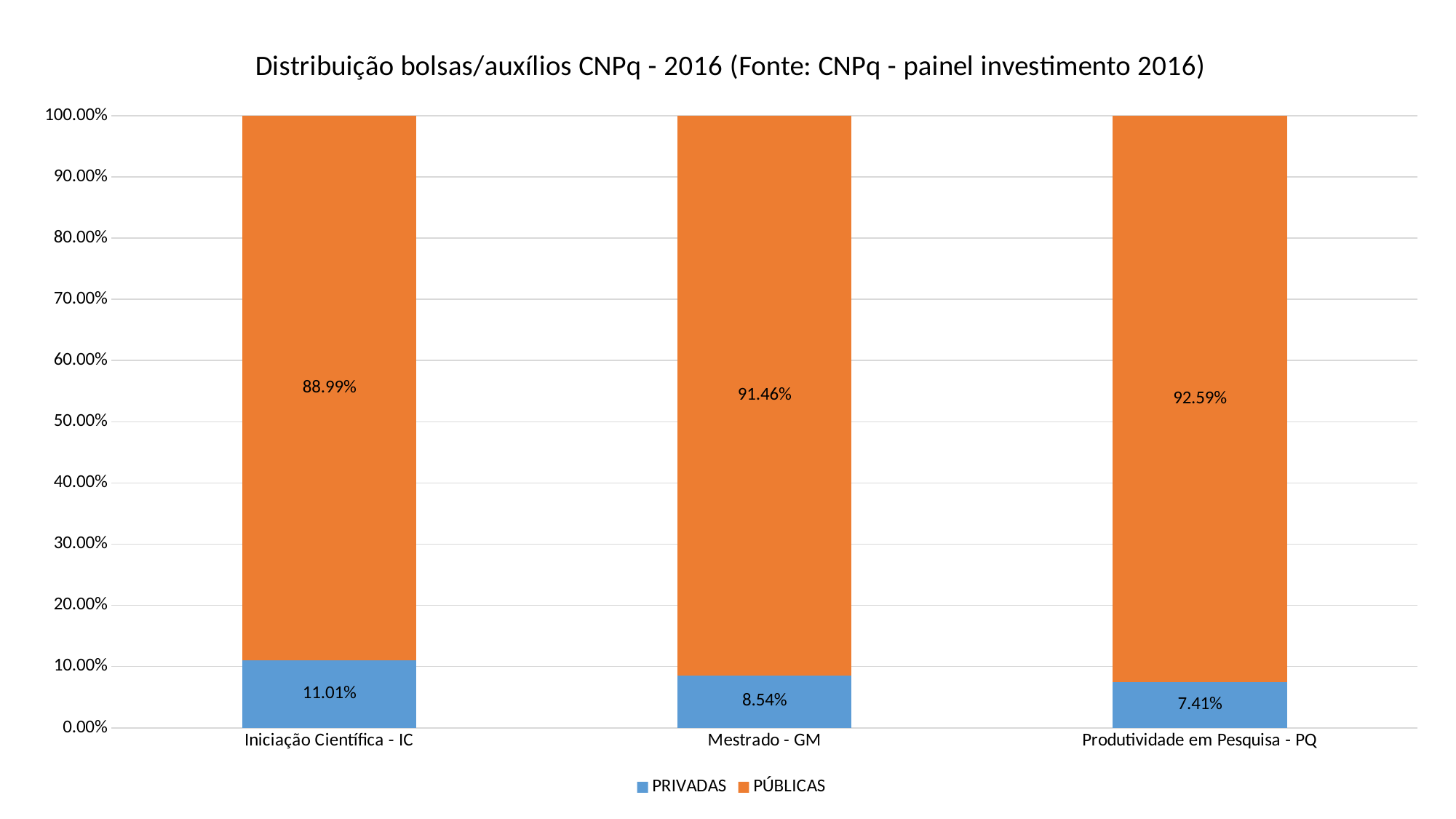
What is the PRIVADAS value for Iniciação Científica - IC? 11.01% Which category has the lowest PÚBLICAS value? Iniciação Científica - IC What kind of chart is shown on the slide? Stacked bar chart What is the difference between the PÚBLICAS values for Produtividade em Pesquisa - PQ and Iniciação Científica - IC? 3.60% Which is larger: the PRIVADAS value for Mestrado - GM or for Produtividade em Pesquisa - PQ? Mestrado - GM What is the PÚBLICAS value for Mestrado - GM? 91.46% How many categories are shown on the x axis? 3 How many series does the legend list? 2 What is the PÚBLICAS value for Produtividade em Pesquisa - PQ? 92.59% What is the PRIVADAS value for Produtividade em Pesquisa - PQ? 7.41% Is the PRIVADAS value for Mestrado - GM greater or less than 10.00%? less Which category has the highest PRIVADAS value? Iniciação Científica - IC